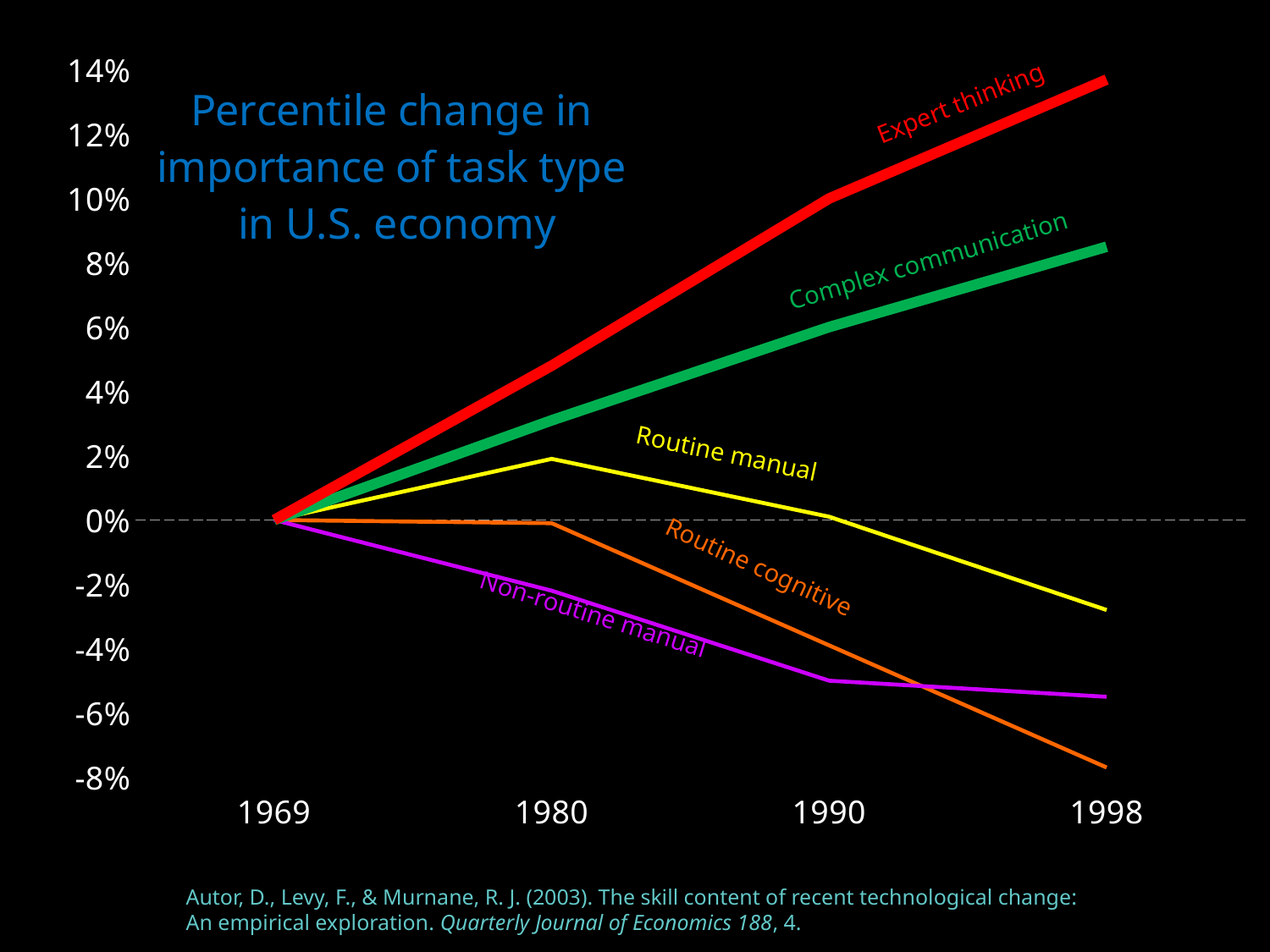
Which task type has the lowest value in 1998? Routine cognitive In 1998, which is larger: Expert thinking or Complex communication? Expert thinking What kind of chart is shown on the slide? line chart Is the value for Expert thinking in 1998 greater or less than 12%? greater Which task type has the highest value in 1998? Expert thinking Is the value for Non-routine manual in 1998 greater or less than -4%? less How many years are marked on the x axis? 4 How many task-type series are plotted on the chart? 5 What is the value for Complex communication in 1969? 0% Is the value for Routine cognitive in 1998 greater or less than -6%? less What is the title of the chart? Percentile change in importance of task type in U.S. economy Does the Routine cognitive line rise or fall from 1980 to 1998? fall